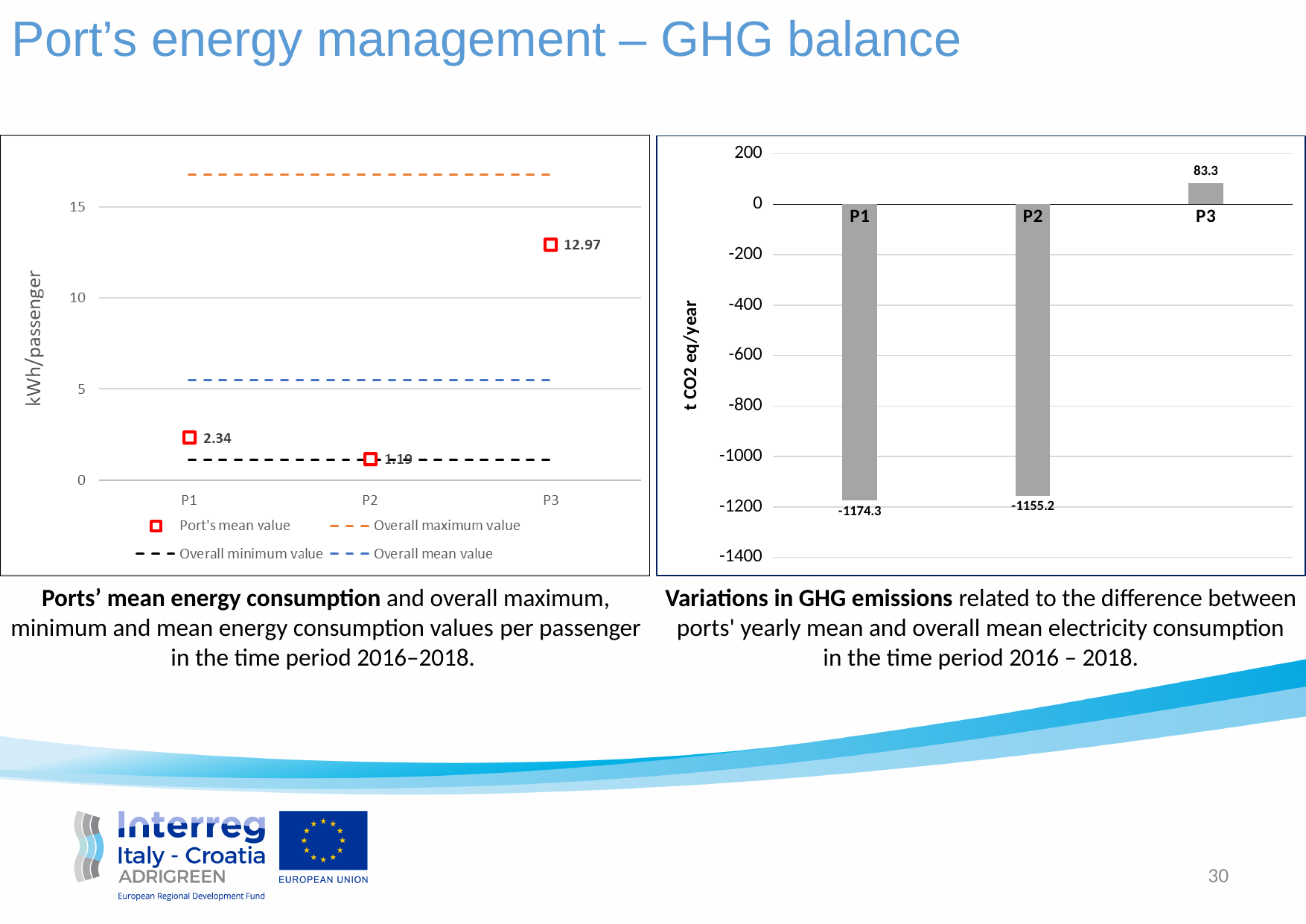
In the right chart, which port has the lowest value? P1 How many series does the legend of the left chart list? 4 In the right chart, what is the value for P1? -1174.3 In the left chart, which port has the highest mean value? P3 In the left chart, is the overall maximum value greater or less than 15? greater What kind of chart is the right chart? Bar chart In the left chart, what is the port's mean value for P1? 2.34 What is the y-axis label of the right chart? t CO2 eq/year In the right chart, what is the value for P3? 83.3 In the right chart, which port has the highest value? P3 In the left chart, what is the port's mean value for P3? 12.97 In the right chart, what is the difference between the values for P2 and P1? 19.1